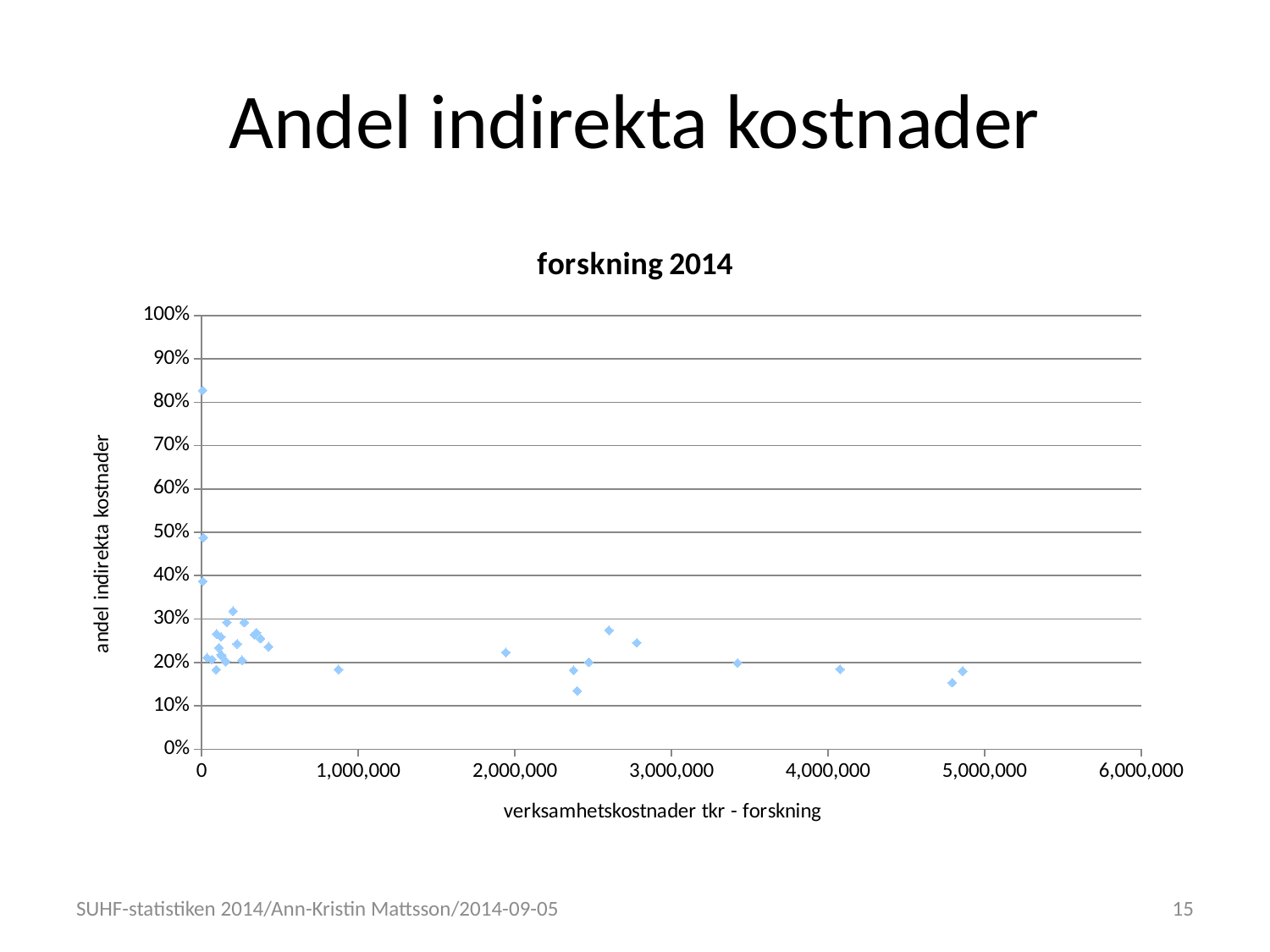
What is the title of the chart? forskning 2014 Are the points plotted near 4,800,000 on the x axis greater or less than 20%? less Which is higher: the point plotted near 2,600,000 on the x axis or the point plotted near 3,400,000? the point near 2,600,000 Is the lowest point on the chart greater or less than 10%? greater What is the label on the x axis of the chart? verksamhetskostnader tkr - forskning Is the point plotted near 4,000,000 on the x axis greater or less than 30%? less Which is higher: the point plotted near 900,000 on the x axis or the point plotted near 2,000,000? the point near 2,000,000 What kind of chart is shown on the slide? scatter chart